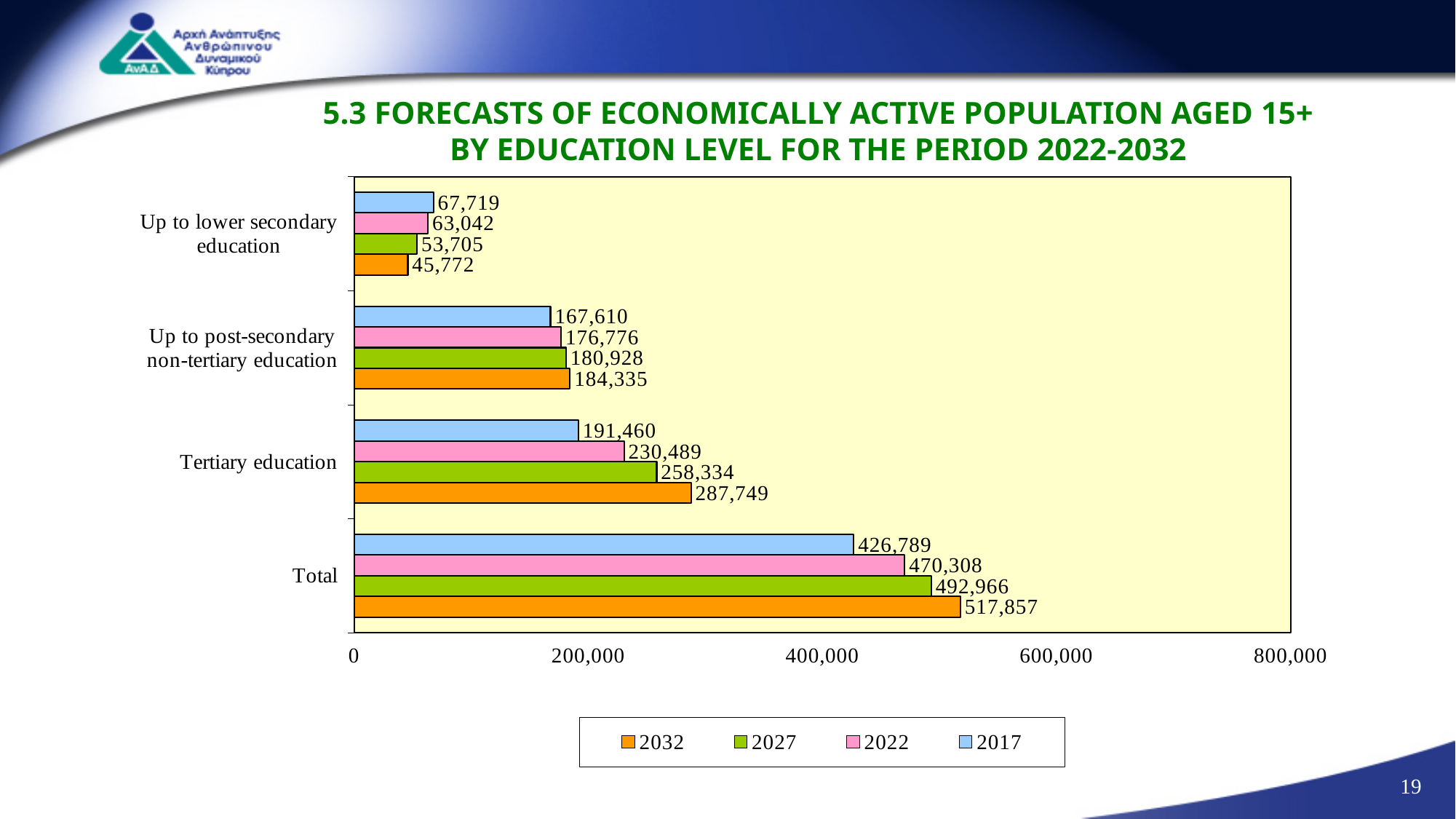
How many education level categories are shown on the chart? 4 What kind of chart is shown on the slide? Bar chart Which year has the highest value for Total? 2032 What is the value for Up to lower secondary education in 2022? 63,042 What is the value for Tertiary education in 2017? 191,460 Do the values for Tertiary education rise or fall from 2017 to 2032? Rise What is the difference between the 2032 and 2017 values for Tertiary education? 96,289 What is the difference between the 2027 and 2022 values for Total? 22,658 Which year has the lowest value for Up to lower secondary education? 2032 What is the value for Total in 2032? 517,857 How many series does the legend list? 4 For Up to post-secondary non-tertiary education, which is larger: the 2027 value or the 2022 value? 2027